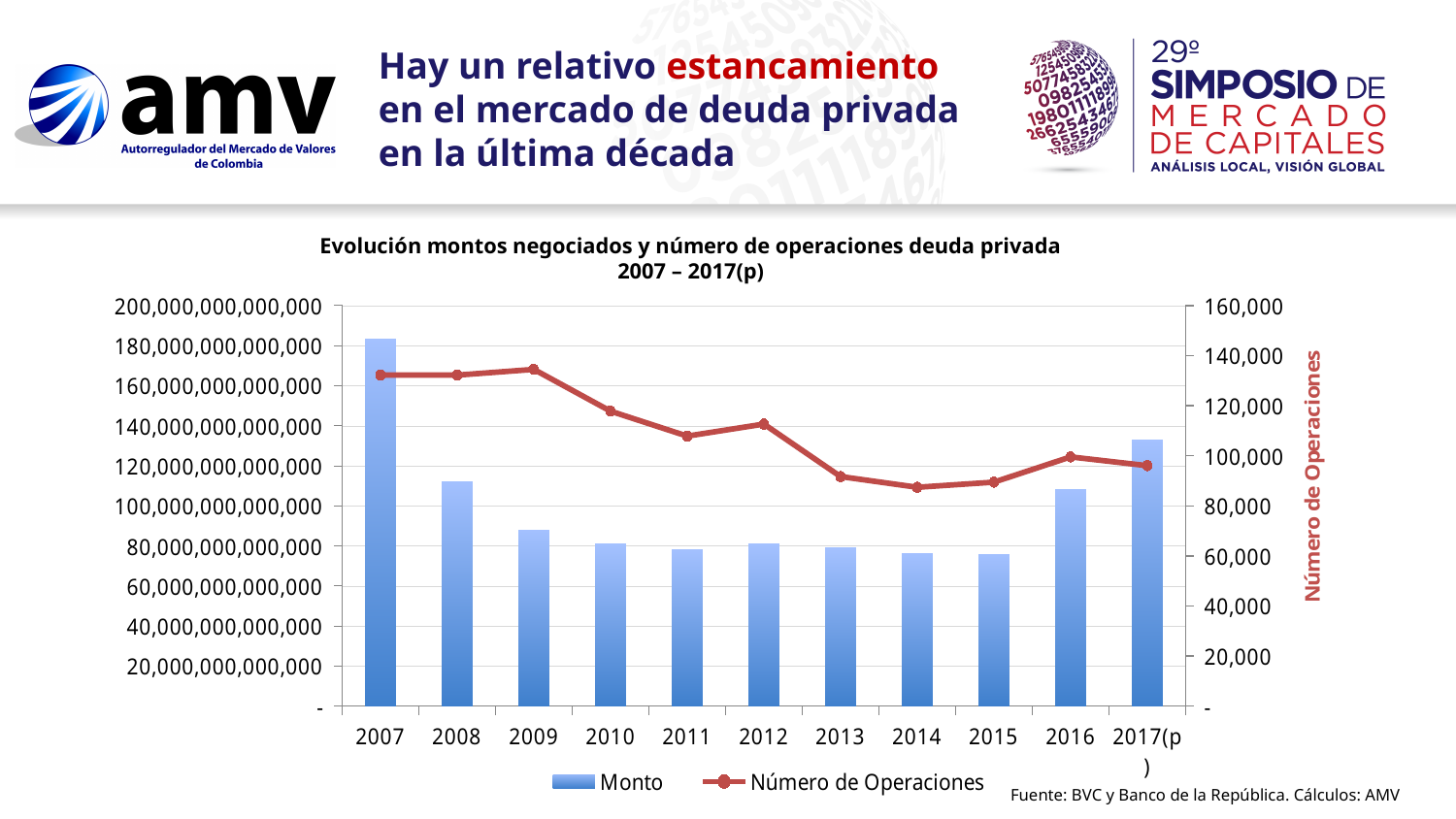
Does the Número de Operaciones line rise or fall from 2009 to 2014? It falls What is the label of the right-hand vertical axis? Número de Operaciones Is the Monto value for 2017(p) greater or less than 120,000,000,000,000? greater Is the Monto value for 2007 greater or less than 160,000,000,000,000? greater Is the Número de Operaciones value for 2014 greater or less than 100,000? less What kind of chart is shown on the slide? A combined bar and line chart How many years are shown on the x axis? 11 Which year has the highest Monto bar? 2007 How many series does the legend list? 2 Which year has the larger Monto bar, 2009 or 2016? 2016